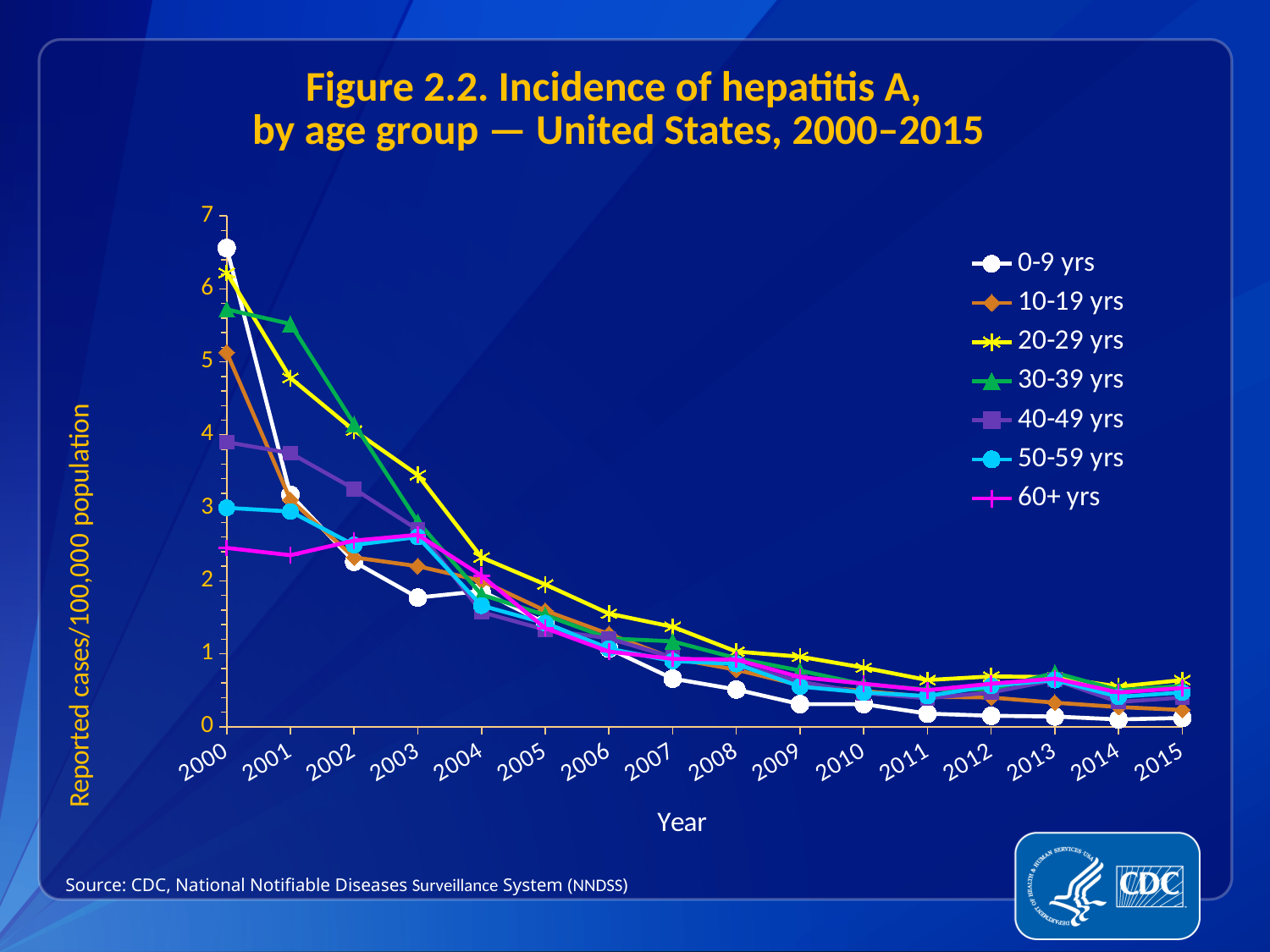
What kind of chart is shown on the slide? line chart In 2001, which was larger: the value for 30-39 yrs or the value for 10-19 yrs? 30-39 yrs How many age-group series does the legend list? 7 What is the label on the y axis? Reported cases/100,000 population Is the value for 0-9 yrs in 2000 greater or less than 6? greater Is the value for 20-29 yrs in 2015 greater or less than 1? less Is the value for 60+ yrs in 2000 greater or less than 3? less Which age group had the highest incidence in 2003? 20-29 yrs Which age group had the lowest incidence in 2000? 60+ yrs How many years are plotted along the x axis? 16 Which age group had the highest incidence in 2000? 0-9 yrs Does the incidence for 0-9 yrs rise or fall from 2000 to 2015? fall